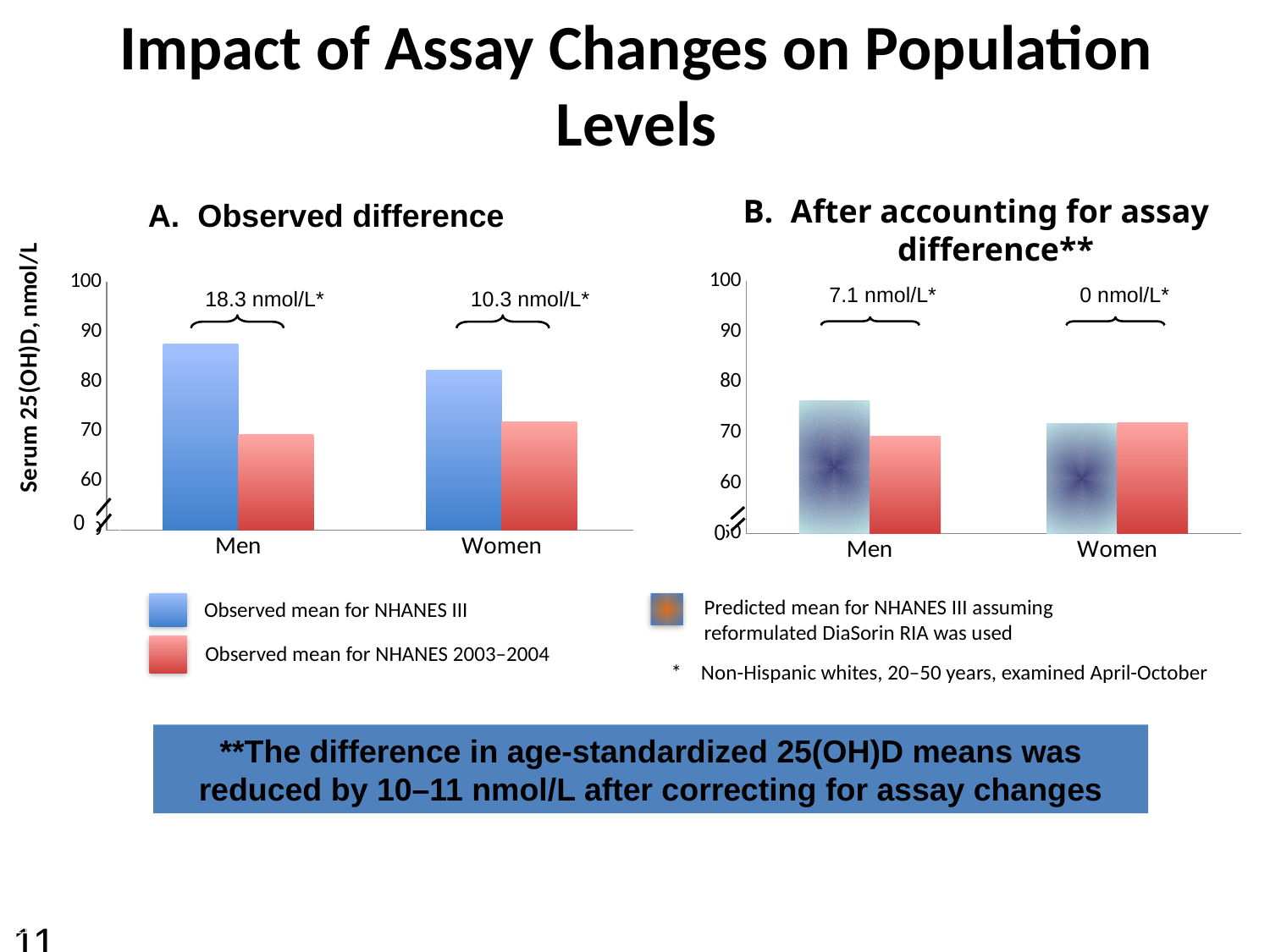
In chart B (After accounting for assay difference), what difference is printed above the Women bars? 0 nmol/L In chart B (After accounting for assay difference), what difference is printed above the Men bars? 7.1 nmol/L In chart A (Observed difference), for Women, which is larger: the NHANES III mean or the NHANES 2003–2004 mean? NHANES III In chart A (Observed difference), what difference is printed above the Women bars? 10.3 nmol/L How many categories are shown on the x axis of chart B (After accounting for assay difference)? 2 What kind of chart is chart A (Observed difference)? Bar chart In chart A (Observed difference), which bar is the tallest? Men, observed mean for NHANES III In chart A (Observed difference), what difference is printed above the Men bars? 18.3 nmol/L In chart A (Observed difference), is the observed mean for NHANES III for Men greater or less than 80? greater What is the label on the y axis of the charts? Serum 25(OH)D, nmol/L In chart B (After accounting for assay difference), is the predicted mean for NHANES III for Men greater or less than 80? less